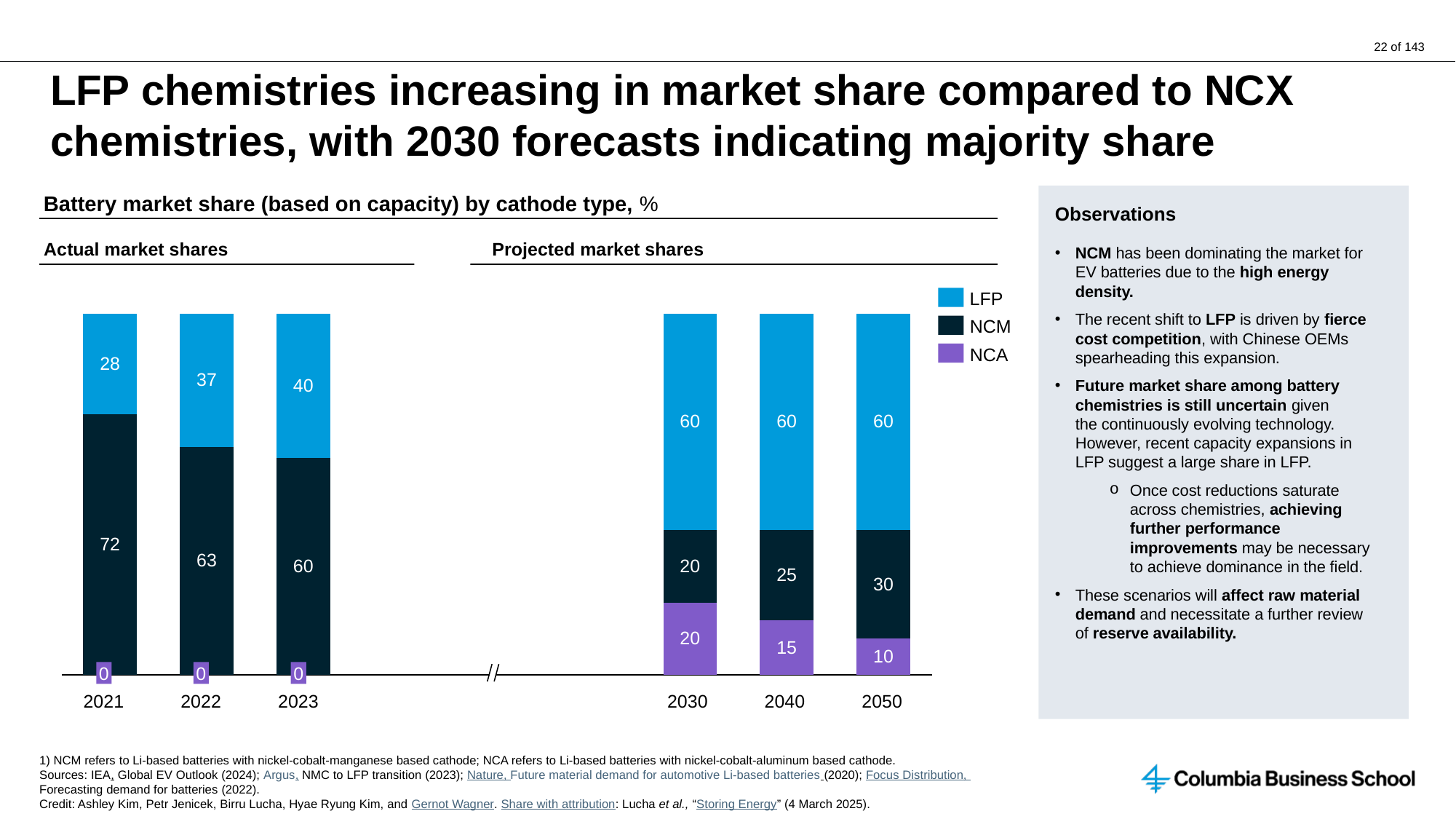
Does the LFP share rise or fall from 2021 to 2023? rise How many series does the legend list? 3 What is the NCM market share shown for 2050? 30 How many years are shown on the x axis of the chart? 6 Which year has the highest NCM market share? 2021 Is the LFP share in 2022 larger or smaller than the LFP share in 2023? smaller Among the projected years, which year has the lowest NCA market share? 2050 What is the NCA market share shown for 2040? 15 What is the LFP market share shown for 2021? 28 What is the NCM market share shown for 2023? 60 What is the difference between the NCM share in 2021 and the NCM share in 2023? 12 What kind of chart is shown on the slide? stacked bar chart